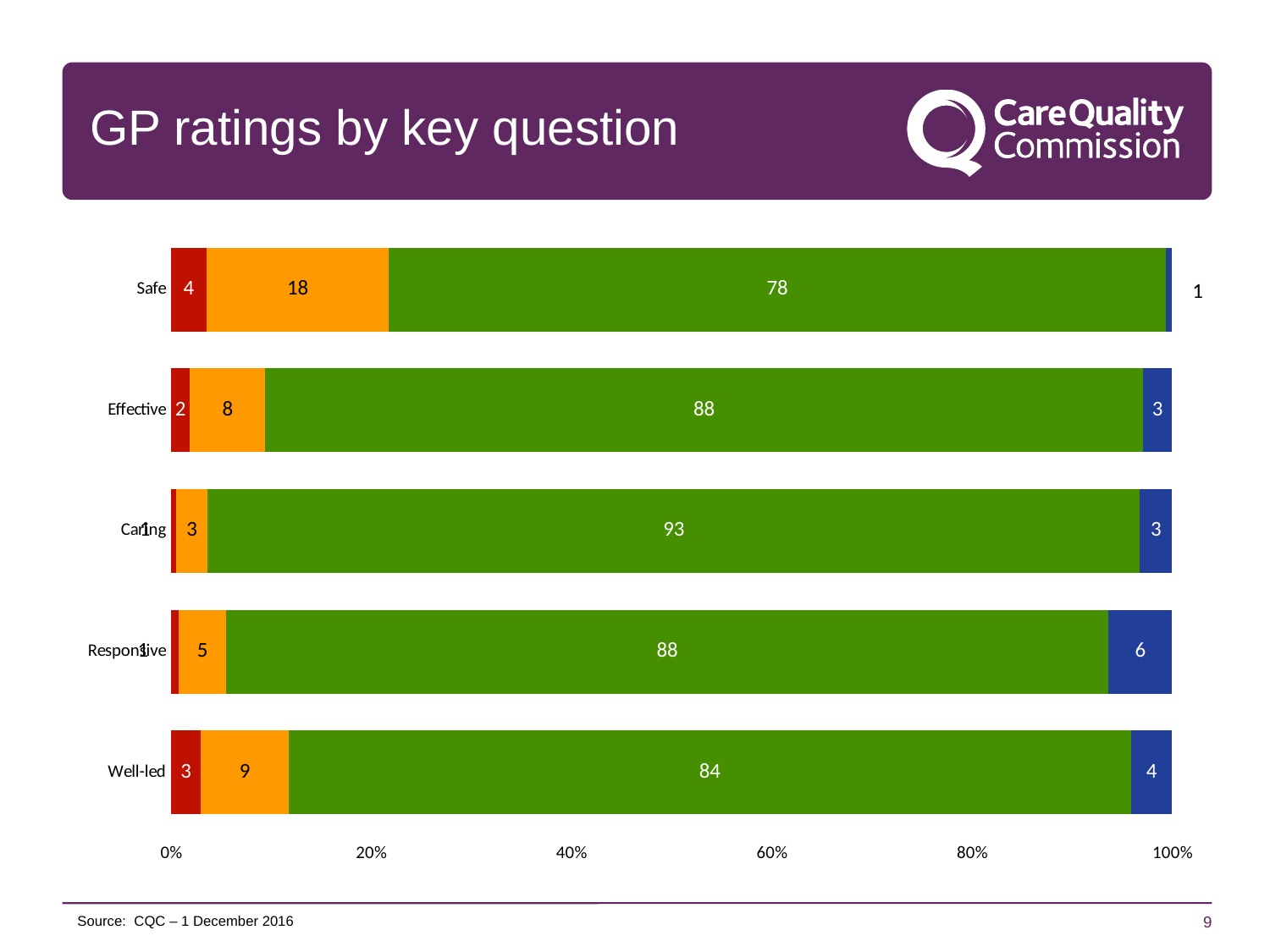
Which is larger, the orange segment for Well-led or the orange segment for Effective? Well-led How many key questions (categories) are shown on the chart? 5 Which key question has the smallest green segment? Safe What is the total of the segments in the Effective bar? 101 What is the value of the green segment for Caring? 93 Which key question has the largest green segment? Caring What kind of chart is shown on the slide? Stacked bar chart What is the value of the orange segment for Safe? 18 What is the value of the blue segment for Responsive? 6 What is the difference between the green segment values for Caring and Safe? 15 What is the title of the slide containing the chart? GP ratings by key question What is the value of the red segment for Well-led? 3